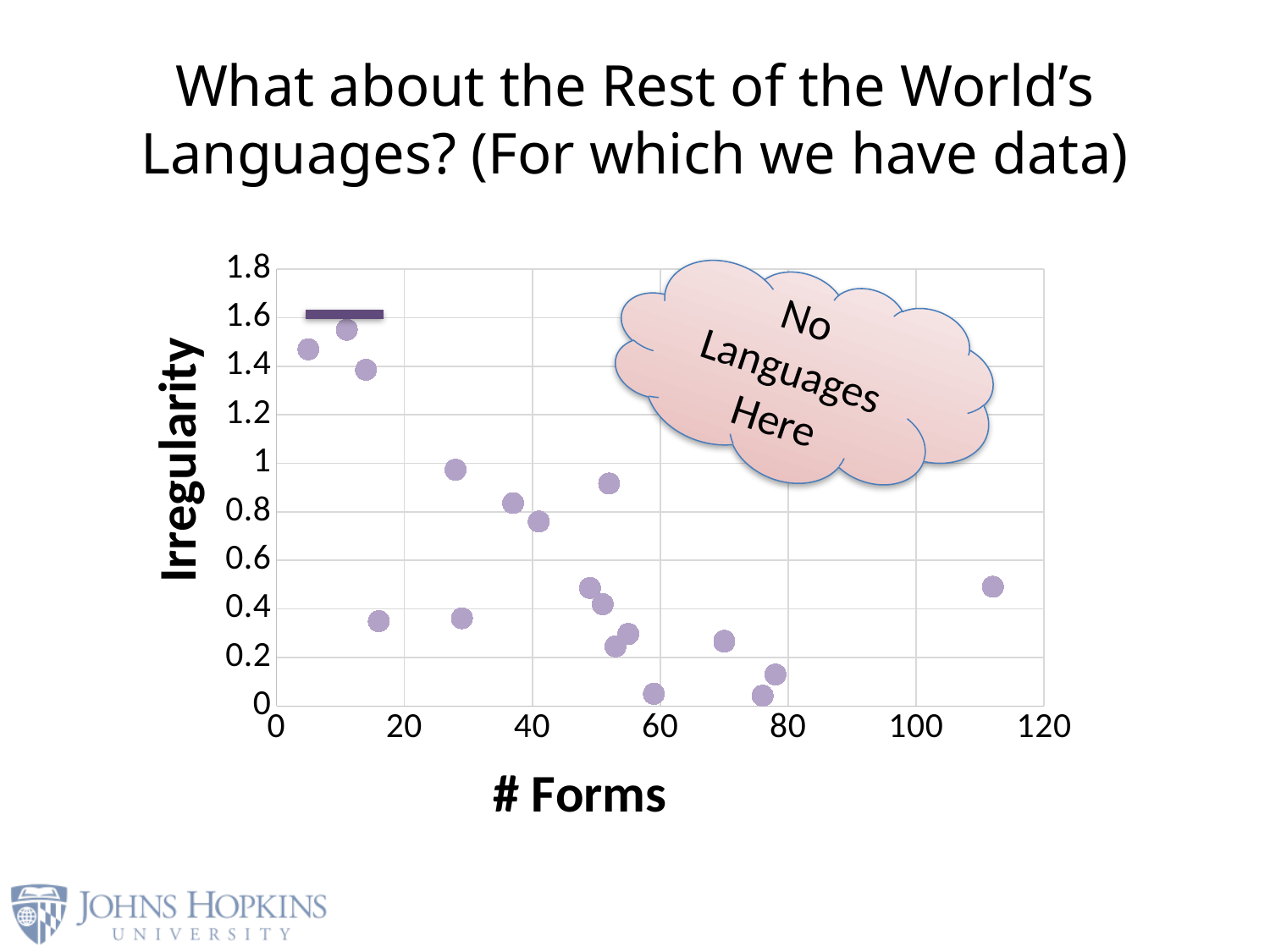
What is the label of the x axis of the chart? # Forms Are there any points plotted with irregularity above 1.0 and more than 60 forms? no Which has the higher irregularity: the point near 28 forms or the point near 70 forms? the point near 28 forms Is the highest irregularity value plotted greater or less than 1.8? less Overall, does irregularity rise or fall as the number of forms increases along the x axis? fall Is the irregularity of the point with the fewest forms (near 5 forms) greater or less than 1.2? greater What is the label of the y axis of the chart? Irregularity Is the highest irregularity value plotted greater or less than 1.4? greater What is the maximum value shown on the x axis? 120 What kind of chart is shown on the slide? scatter plot